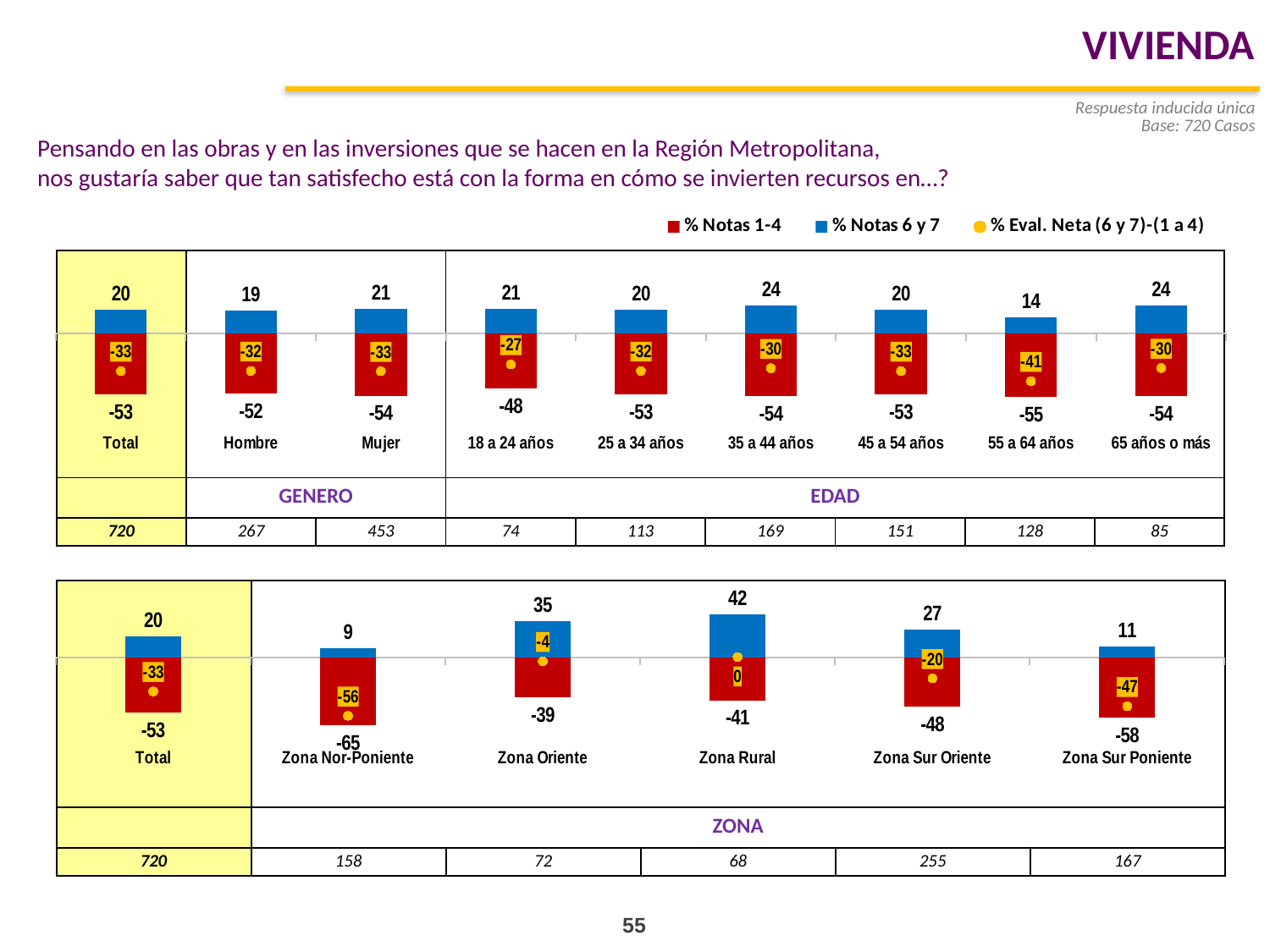
In the top chart, what is the difference between the % Notas 6 y 7 values for Mujer and Hombre? 2 In the bottom chart, which zone has the highest % Notas 6 y 7 value? Zona Rural In the bottom chart, what is the % Notas 1-4 value for Zona Nor-Poniente? -65 In the bottom chart, which is larger in % Notas 6 y 7: Zona Oriente or Zona Sur Oriente? Zona Oriente In the top chart, what is the % Eval. Neta value for 18 a 24 años? -27 In the bottom chart, how many zone categories are shown, excluding Total? 5 What kind of chart is used on this slide? Combination bar and line chart (bars with a dot-marker series) In the top chart, what is the % Notas 1-4 value for Mujer? -54 In the top chart, what is the % Notas 6 y 7 value for 55 a 64 años? 14 In the top chart, which age group has the lowest % Notas 6 y 7 value? 55 a 64 años In the bottom chart, what is the % Eval. Neta value for Zona Rural? 0 How many series does the legend list? 3